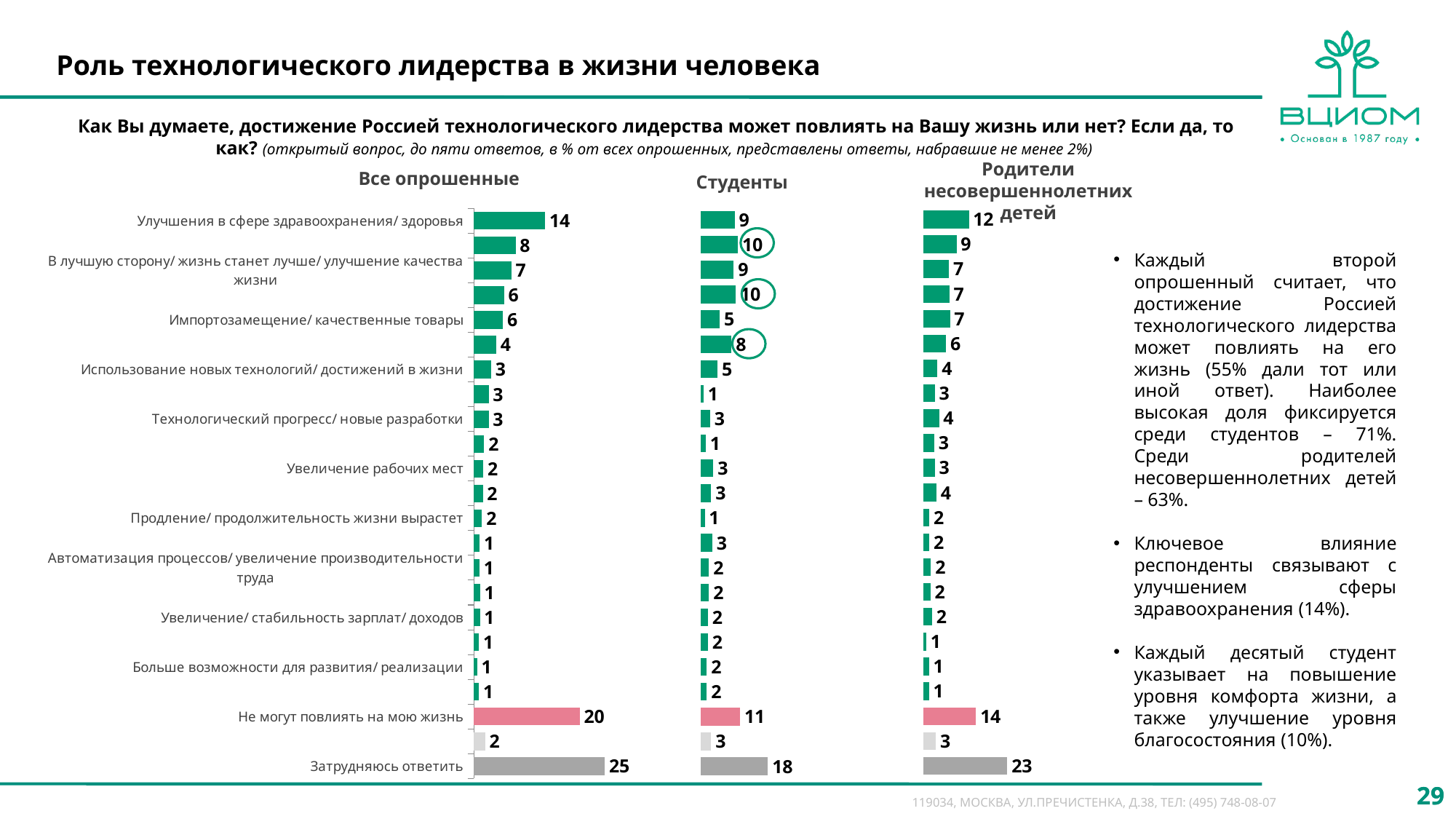
In the 'Все опрошенные' chart, what is the value for 'Улучшения в сфере здравоохранения/ здоровья'? 14 In the 'Родители несовершеннолетних детей' chart, what is the value for 'Затрудняюсь ответить'? 23 Which is larger: the value for 'Улучшения в сфере здравоохранения/ здоровья' in the 'Все опрошенные' chart or in the 'Студенты' chart? Все опрошенные In the 'Все опрошенные' chart, what is the difference between 'Не могут повлиять на мою жизнь' and 'Улучшения в сфере здравоохранения/ здоровья'? 6 In the 'Родители несовершеннолетних детей' chart, what is the value for 'Импортозамещение/ качественные товары'? 7 Which is larger: the value for 'Не могут повлиять на мою жизнь' in the 'Студенты' chart or in the 'Родители несовершеннолетних детей' chart? Родители несовершеннолетних детей In the 'Студенты' chart, what is the value for 'Использование новых технологий/ достижений в жизни'? 5 What type of chart is used on this slide? Bar chart In the 'Студенты' chart, what is the difference between 'Затрудняюсь ответить' and 'Не могут повлиять на мою жизнь'? 7 How many separate charts are shown on the slide? 3 In the 'Студенты' chart, what is the value for 'Не могут повлиять на мою жизнь'? 11 In the 'Все опрошенные' chart, which category has the highest value? Затрудняюсь ответить